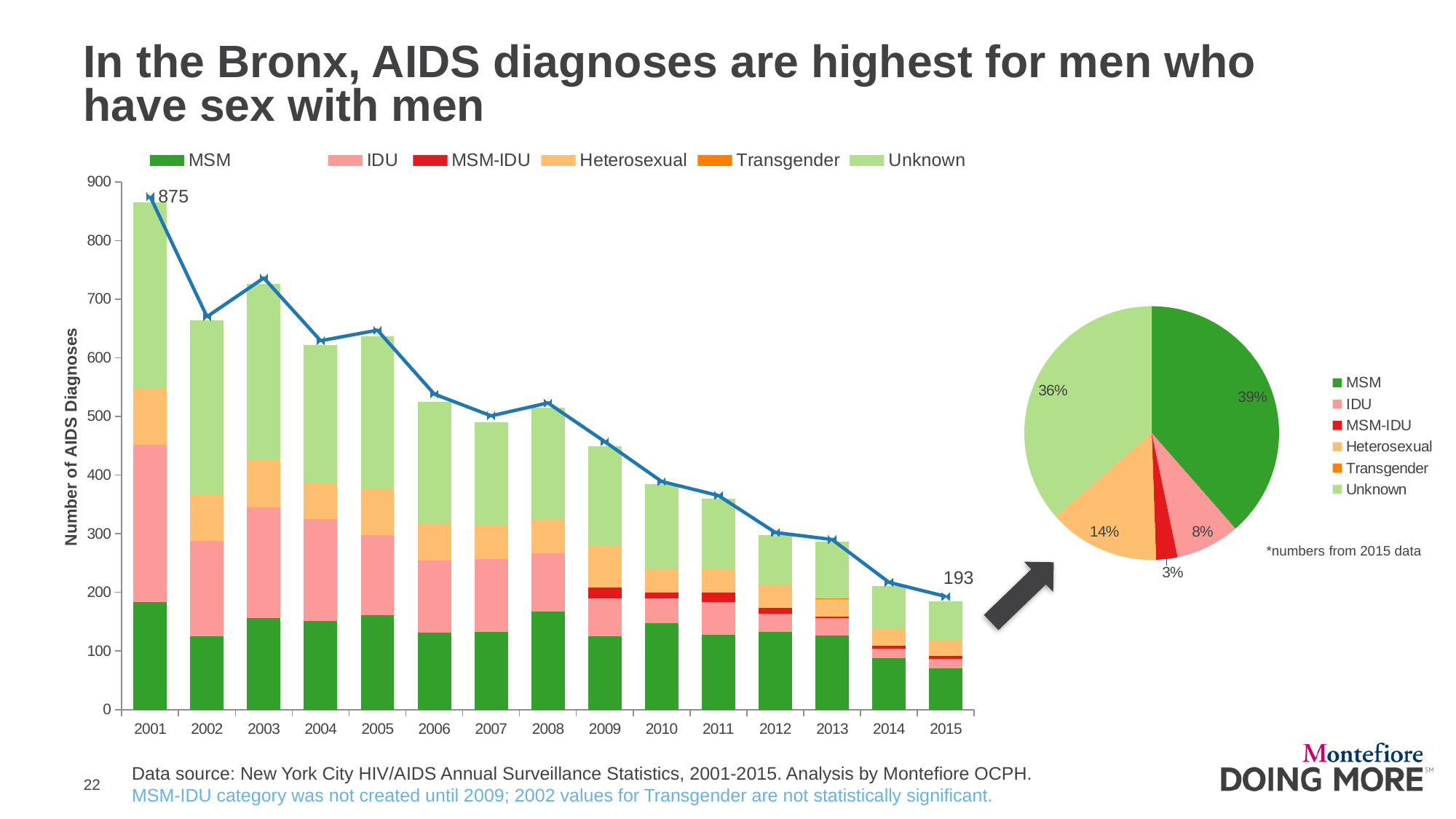
In the pie chart, what share is MSM? 39% How many series does the legend of the stacked bar chart list? 6 In the stacked bar chart, do the total AIDS diagnoses rise or fall from 2001 to 2015? Fall In the stacked bar chart, what value is labelled on the line for 2001? 875 What kind of chart is the chart on the left of the slide? Stacked bar chart with a line In the pie chart, what share is Unknown? 36% In the pie chart, which category has the largest slice? MSM In the stacked bar chart, is the total for 2014 greater or less than 300? less In the stacked bar chart, what value is labelled on the line for 2015? 193 In the pie chart, which is larger, Heterosexual or IDU? Heterosexual How many years are shown on the x axis of the stacked bar chart? 15 In the stacked bar chart, what is the difference between the labelled values for 2001 and 2015? 682